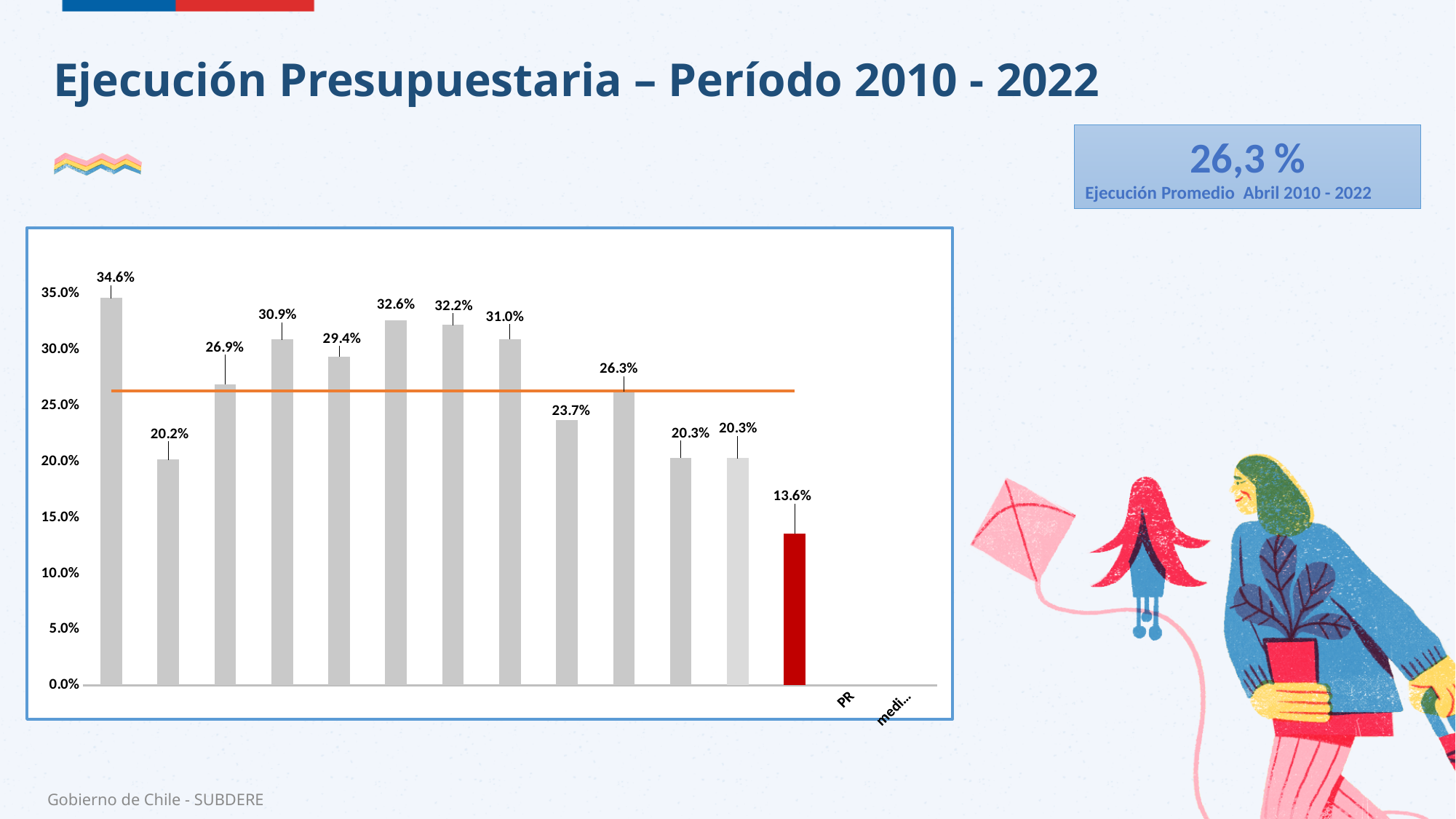
What average execution value is shown in the box at the top right of the slide? 26,3 % What is the highest value shown by a bar in the chart? 34.6% Which is larger, the first bar (34.6%) or the second bar (20.2%)? the first bar (34.6%) How many bars are plotted in the chart? 13 What value is labelled on the red bar at the right of the chart? 13.6% What colour is the bar with the lowest value in the chart? red What is the difference between the first bar (34.6%) and the red bar (13.6%)? 21.0% What is the lowest value shown by a bar in the chart? 13.6% What value is labelled on the first (leftmost) bar of the chart? 34.6% Is the value of the red bar greater or less than 15.0%? less How many bars in the chart have a value above 30.0%? 5 What kind of chart is shown on the slide? combination bar and line chart